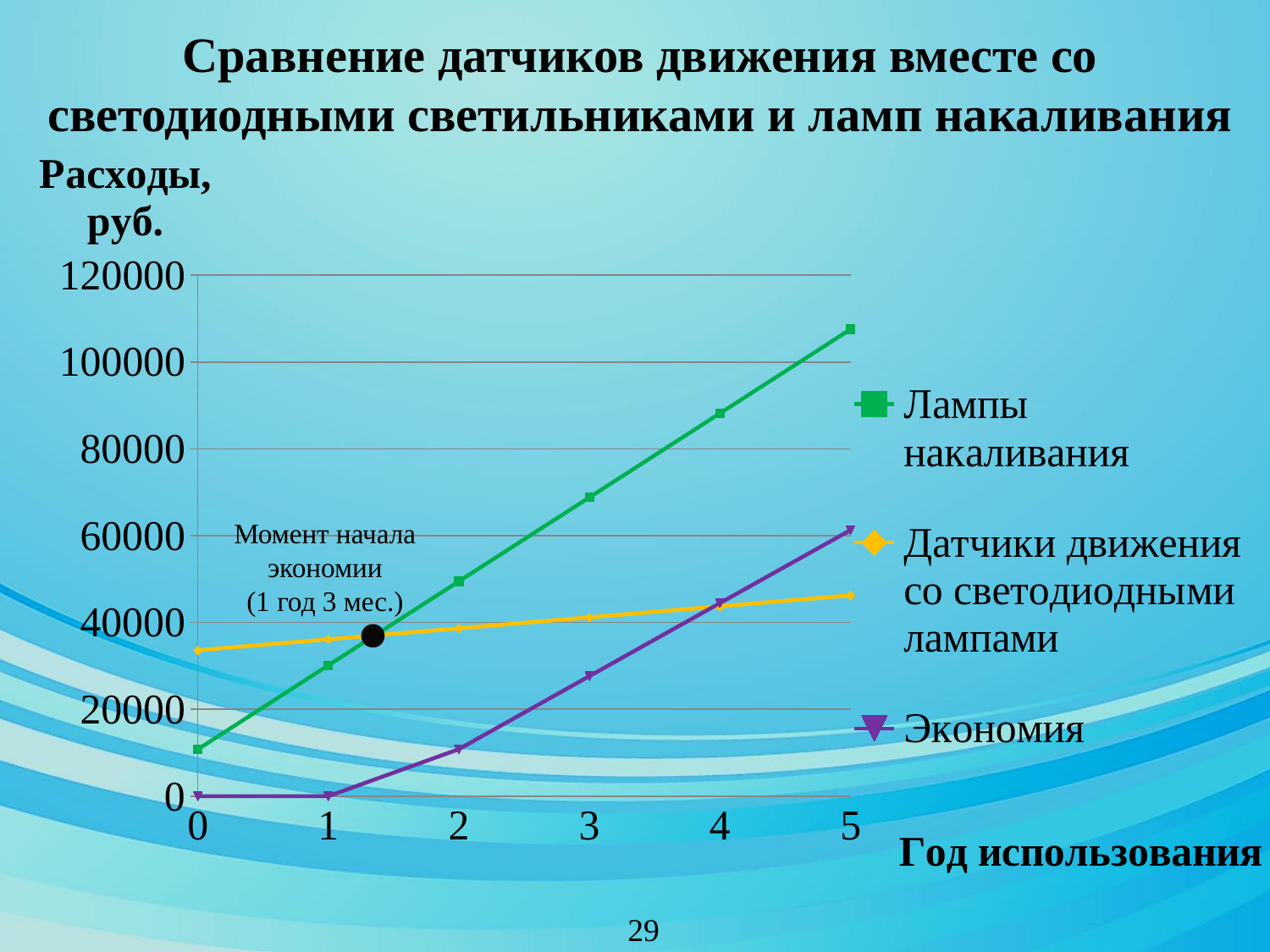
Is the value for Лампы накаливания at year 5 greater or less than 100000? greater At year 0, which is higher: Лампы накаливания or Датчики движения со светодиодными лампами? Датчики движения со светодиодными лампами Is the value for Экономия at year 1 greater or less than 20000? less How many series does the legend list? 3 How many points along the x axis (years of use) are plotted for each series? 6 What kind of chart is shown on the slide? line chart Is the value for Датчики движения со светодиодными лампами at year 5 greater or less than 60000? less Which series has the lowest value at year 0? Экономия According to the annotation on the chart, when does the saving begin (Момент начала экономии)? 1 год 3 мес. At year 5, which is higher: Лампы накаливания or Датчики движения со светодиодными лампами? Лампы накаливания Do the values for Лампы накаливания rise or fall as the year of use increases? rise